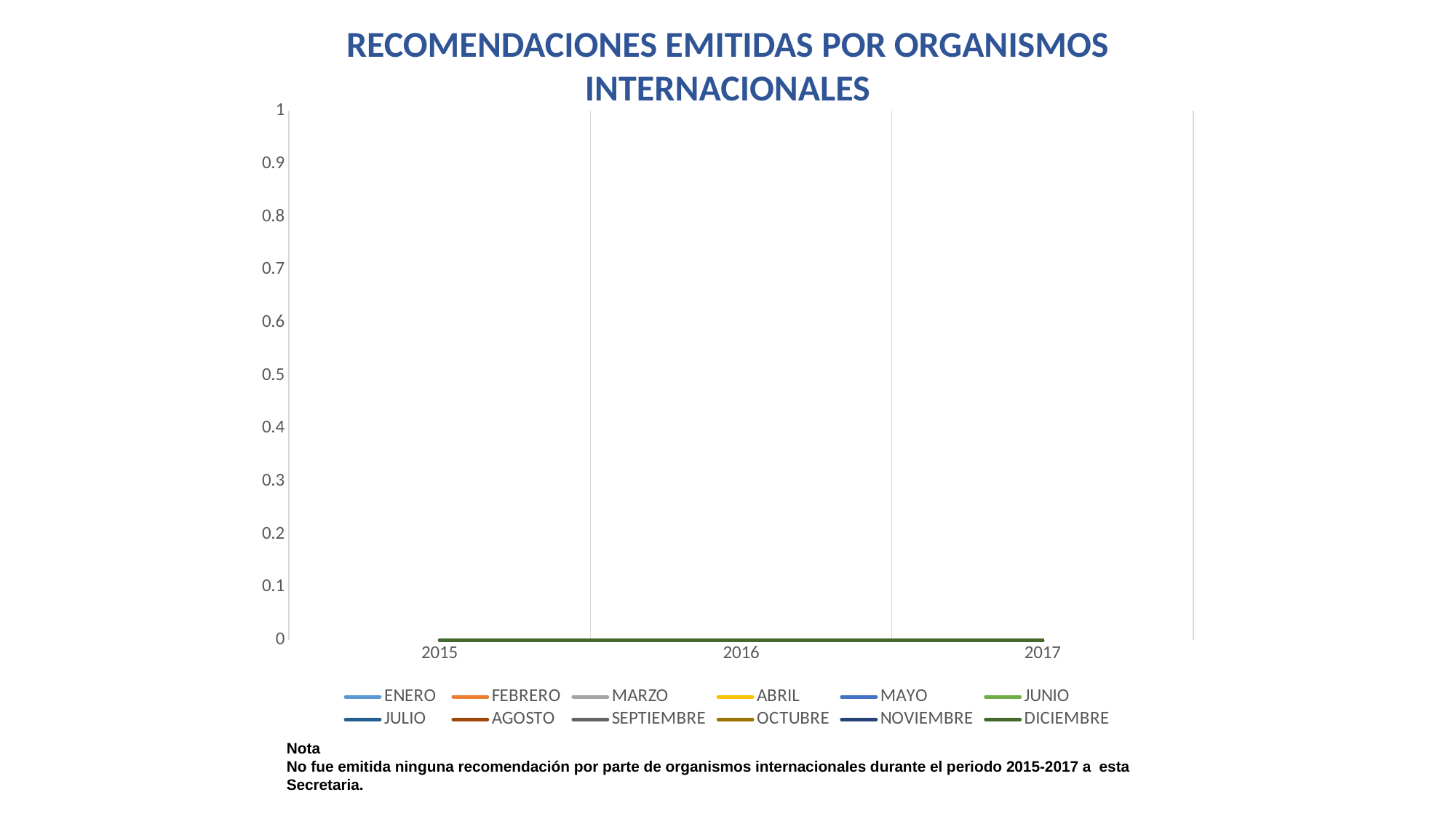
What kind of chart is shown on the slide? line chart How many years are shown on the x axis? 3 What is the title of the chart? RECOMENDACIONES EMITIDAS POR ORGANISMOS INTERNACIONALES What is the highest value shown on the y axis? 1 What is the value for DICIEMBRE in 2017? 0 Is the value for DICIEMBRE in 2017 greater or less than 0.5? less How many series does the legend list? 12 Do the plotted values rise, fall or stay flat from 2015 to 2017? stay flat Which year is the last category on the x axis? 2017 Which year is the first category on the x axis? 2015 What is the value for DICIEMBRE in 2015? 0 What is the value for DICIEMBRE in 2016? 0